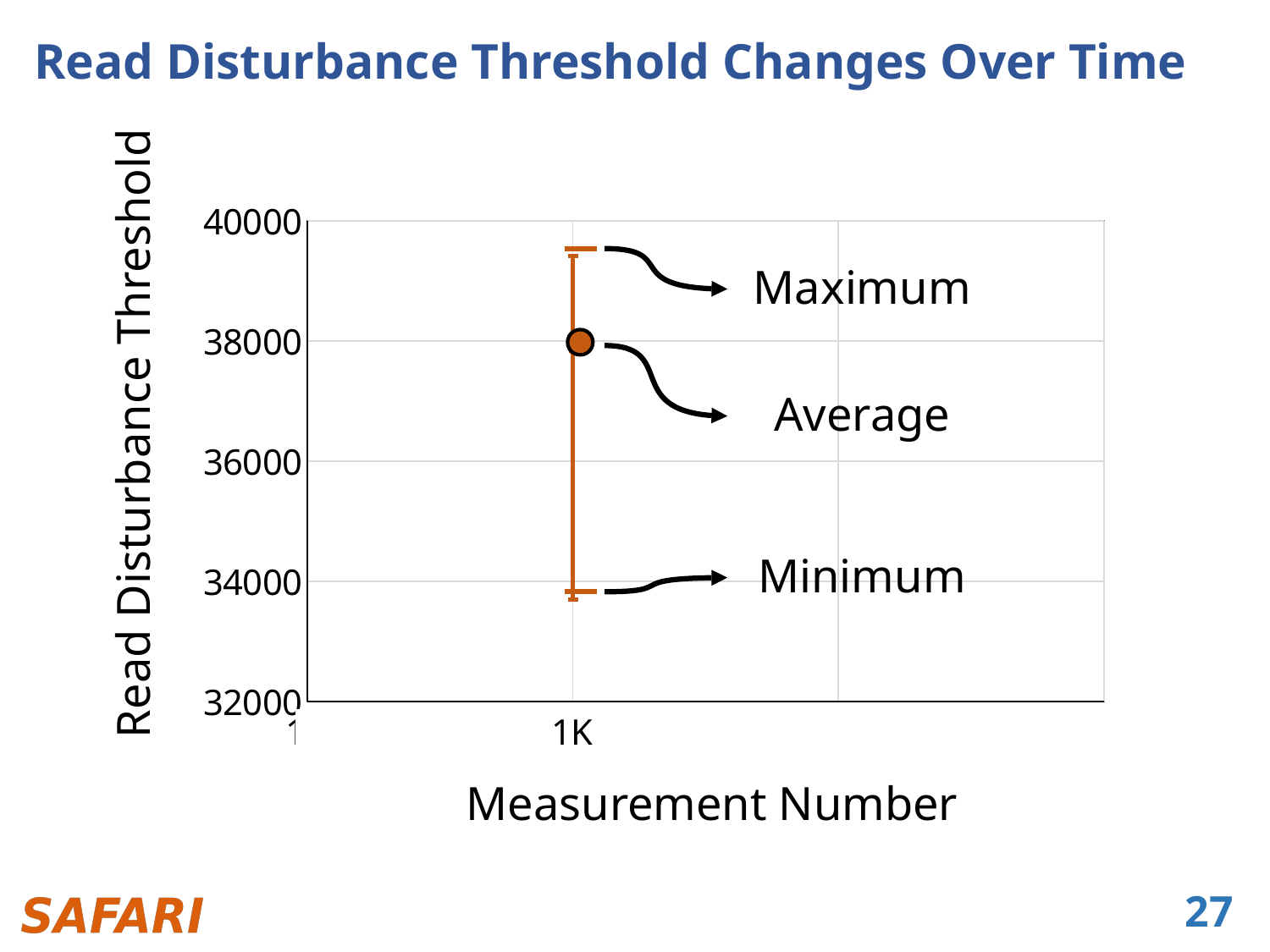
Which is larger at measurement 1K, the Maximum or the Minimum? Maximum How many measurement points are plotted on the chart? 1 What is the highest value shown on the y axis? 40000 Is the Maximum value at measurement 1K greater or less than 40000? less Is the Average value at measurement 1K greater or less than 36000? greater Which is larger at measurement 1K, the Average or the Minimum? Average Is the Minimum value at measurement 1K greater or less than 32000? greater What is the title of the chart? Read Disturbance Threshold Changes Over Time What is the label of the y axis? Read Disturbance Threshold At which measurement number is the data point plotted? 1K